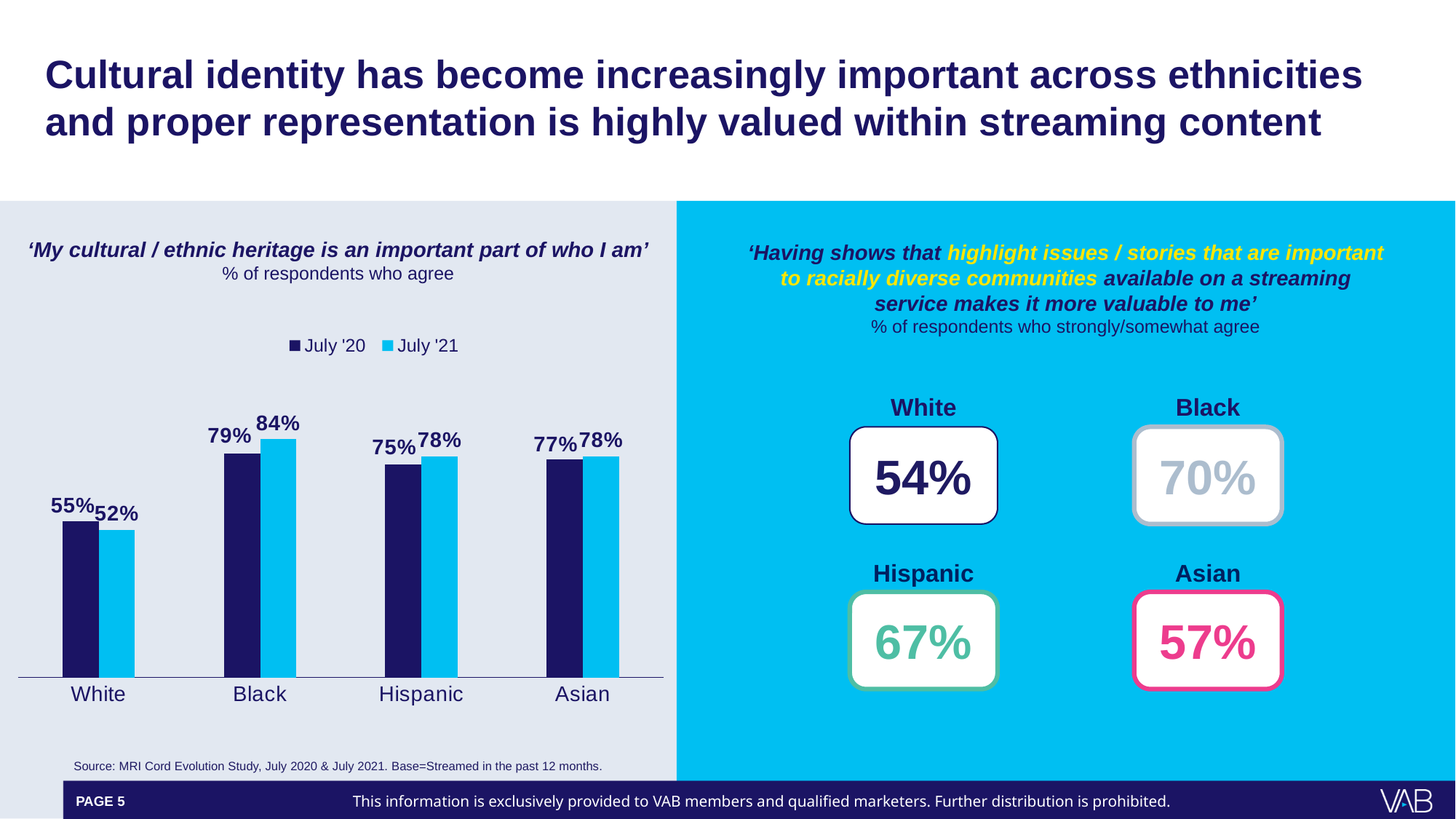
In the bar chart on the left, what is the difference between the July '21 and July '20 values for Black respondents? 5% In the bar chart on the left, what is the July '20 value for White respondents? 55% In the bar chart on the left, how many series does the legend list? 2 In the bar chart on the left, is the July '20 value for Asian respondents larger or smaller than the July '20 value for Hispanic respondents? larger In the bar chart on the left, which series is shown in dark navy? July '20 In the bar chart on the left, did the value for White respondents rise or fall from July '20 to July '21? fall In the bar chart on the left, what is the July '21 value for Black respondents? 84% In the bar chart on the left, how many categories are shown on the x axis? 4 In the bar chart on the left, which category has the lowest July '20 value? White What type of chart is shown on the left side of the slide? bar chart In the bar chart on the left, which category has the highest July '21 value? Black In the bar chart on the left, what is the July '21 value for Hispanic respondents? 78%